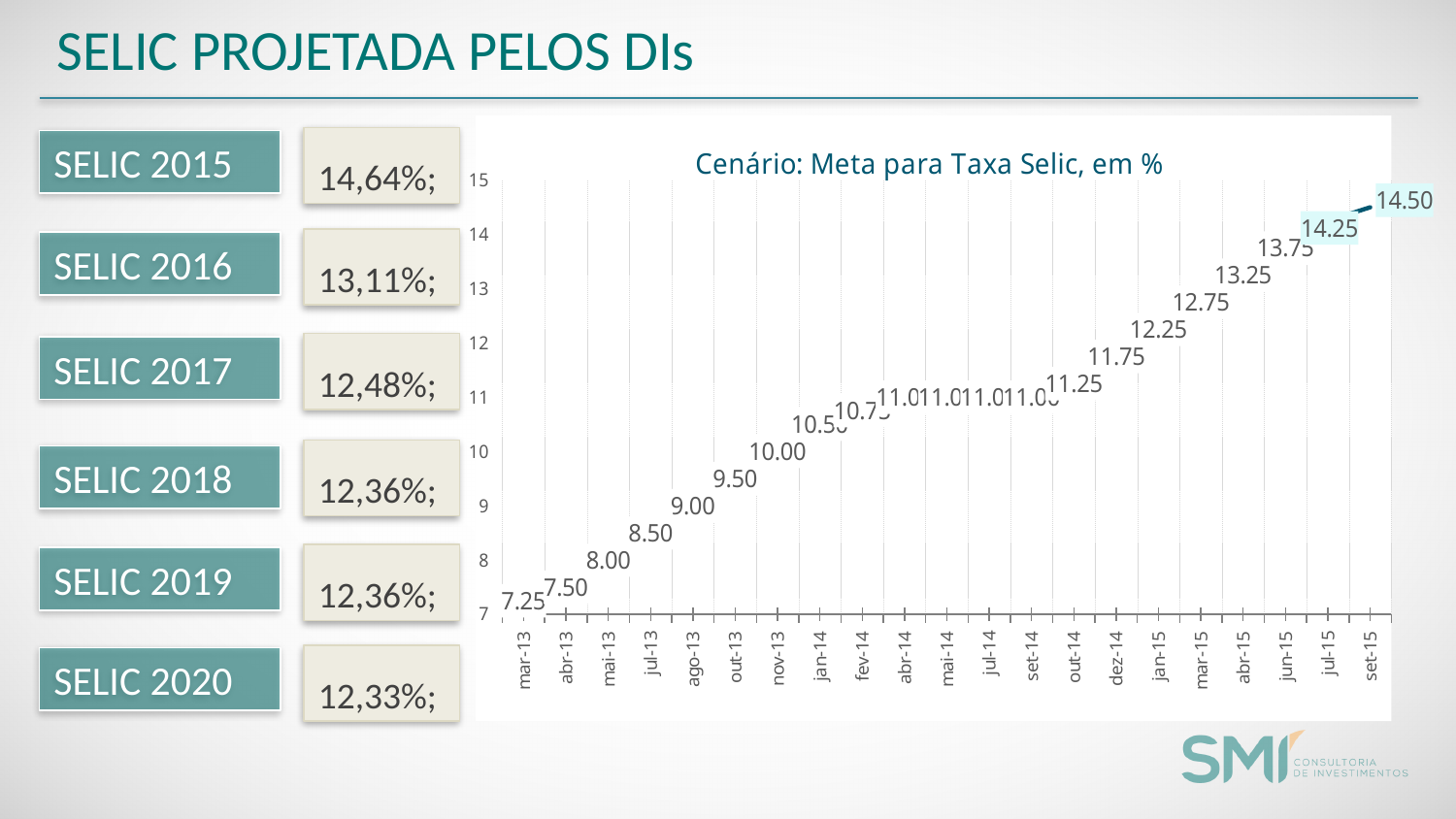
Which is larger, the value at mar-13 or the value at set-15? set-15 What is the lowest value shown on the vertical axis of the chart? 7 What is the lowest value labelled on the chart? 7.25 What kind of chart is shown on the slide? line chart What is the difference between the last labelled value (14.50) and the first labelled value (7.25)? 7.25 What is the value of the first data point on the chart (mar-13)? 7.25 What is the title of the chart? Cenário: Meta para Taxa Selic, em % Do the values on the chart rise or fall from mar-13 to set-15? rise What is the value of the last data point on the chart (set-15)? 14.50 Is the value for mar-13 greater or less than 8? less What is the highest value labelled on the chart? 14.50 Is the value for set-15 greater or less than 14? greater